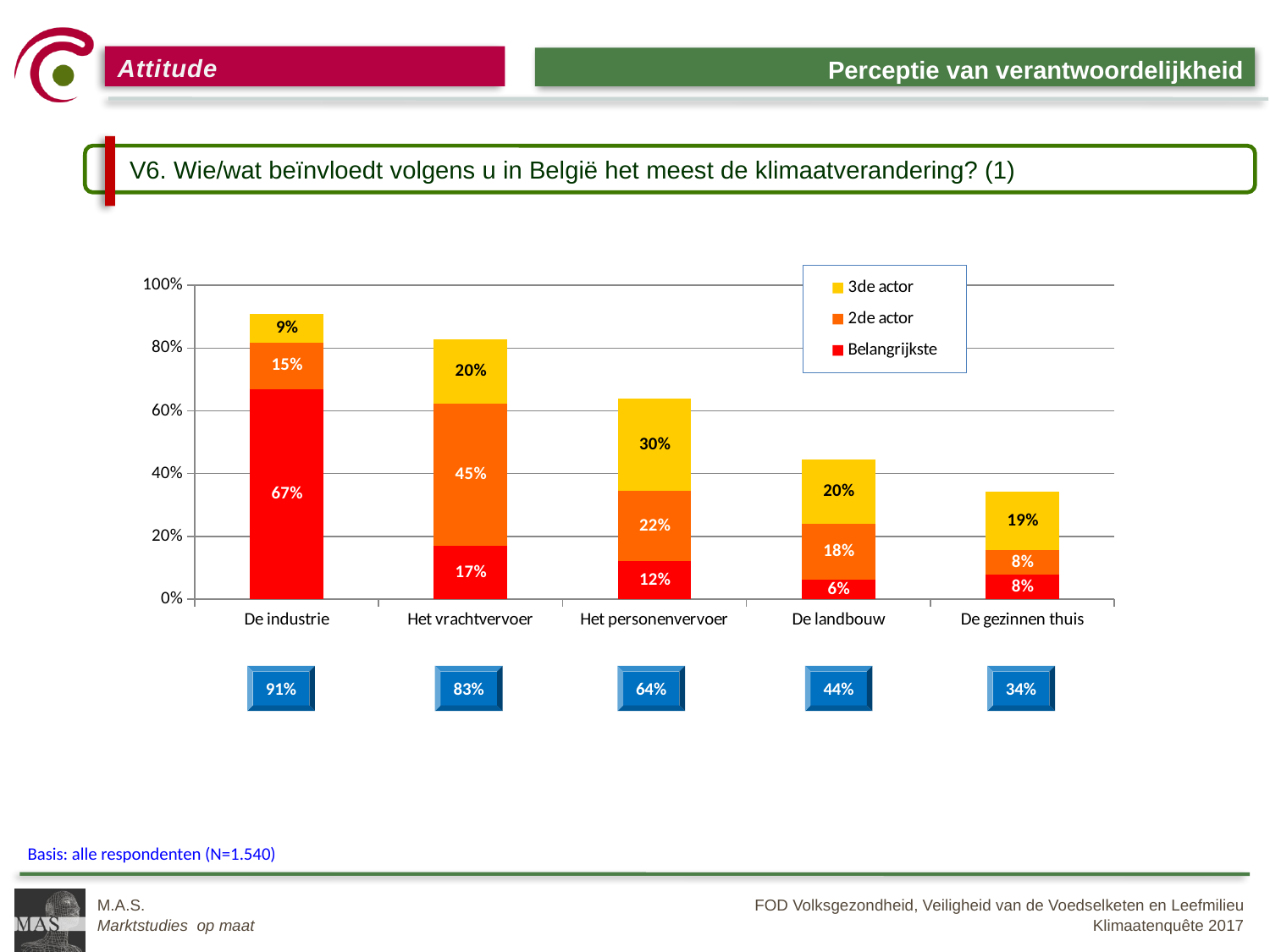
How many categories are shown on the x axis of the chart? 5 Which is larger: the '2de actor' value for Het personenvervoer or for De landbouw? Het personenvervoer What is the 'Belangrijkste' value for De industrie? 67% What is the total of the stacked bar for De industrie? 91% Which category has the highest 'Belangrijkste' value? De industrie What kind of chart is shown on the slide? Stacked bar chart What is the difference between the 'Belangrijkste' values for De industrie and Het vrachtvervoer? 50 percentage points What is the 'Belangrijkste' value for De landbouw? 6% What is the '3de actor' value for Het personenvervoer? 30% How many series does the legend list? 3 What is the '2de actor' value for Het vrachtvervoer? 45% Which category has the lowest 'Belangrijkste' value? De landbouw